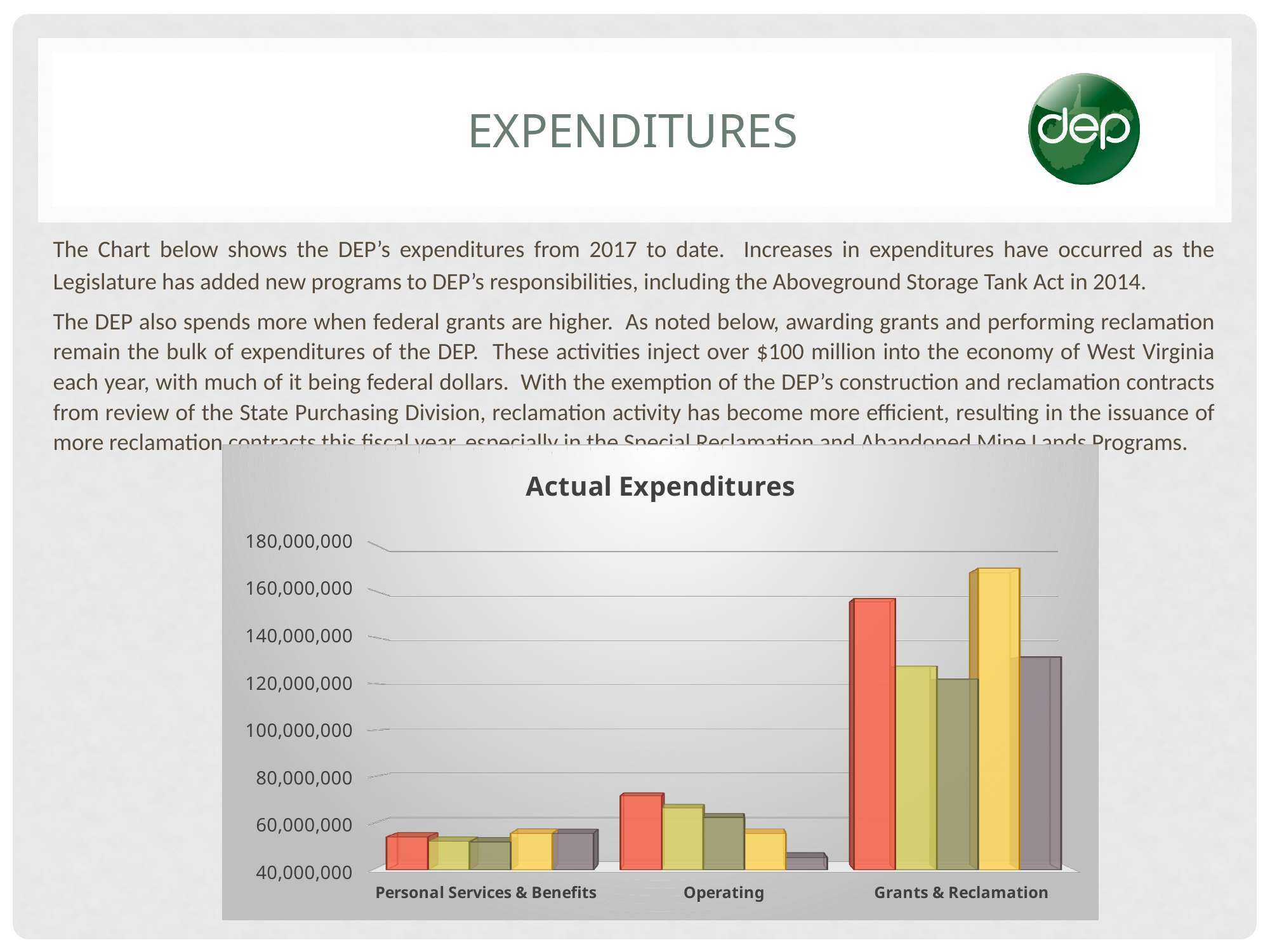
What is the title of the chart? Actual Expenditures Which category has the highest expenditures in the chart? Grants & Reclamation Is the value of the tallest bar for Grants & Reclamation greater or less than 160,000,000? greater For Grants & Reclamation, which is larger: the red bar or the yellow bar? the yellow bar What is the highest value shown on the chart's vertical axis? 180,000,000 What kind of chart is shown on the slide? bar chart Is the value of the red bar for Grants & Reclamation greater or less than 140,000,000? greater Is the value of the red bar for Operating greater or less than 60,000,000? greater Which category has the lowest expenditures in the chart? Personal Services & Benefits How many bars are plotted for each category in the chart? 5 How many categories are shown on the x axis of the chart? 3